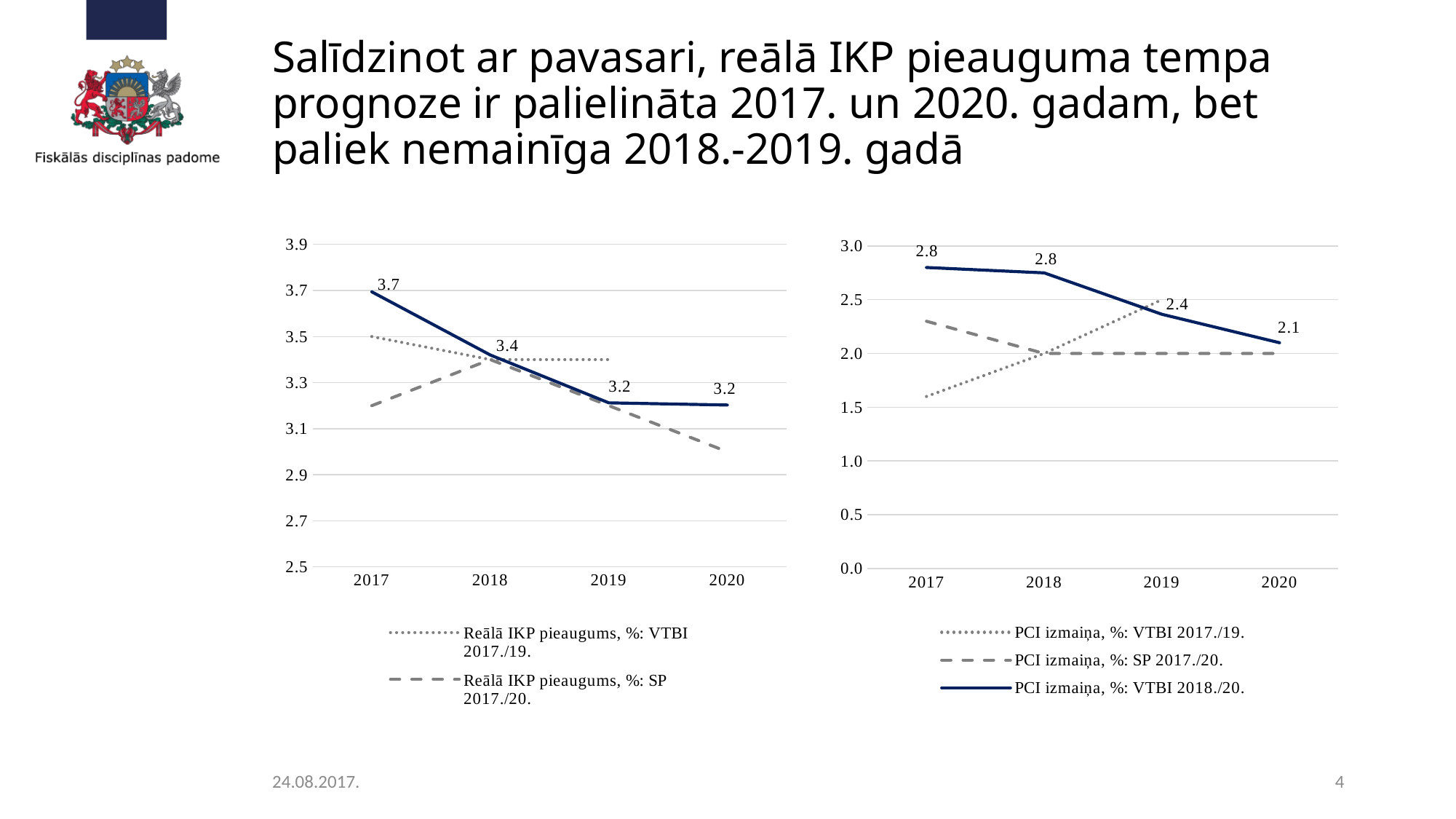
In the left chart, what is the data label shown for 2018 on the solid line? 3.4 In the right chart, how many series does the legend list? 3 In the right chart, what is the value labelled for 2019 on the solid 'PCI izmaiņa, %: VTBI 2018./20.' line? 2.4 In the right chart, what is the difference between the solid line's labelled values for 2017 and 2020? 0.7 In the right chart, what is the value labelled for 2020 on the solid 'PCI izmaiņa, %: VTBI 2018./20.' line? 2.1 In the left chart, what is the difference between the solid line's labelled values for 2017 and 2019? 0.5 In the left chart, what is the data label shown for 2017 on the solid line? 3.7 In the left chart, is the 2020 value of the dashed 'Reālā IKP pieaugums, %: SP 2017./20.' line greater or less than 3.1? less In the left chart, does the solid line rise or fall from 2017 to 2019? fall In the left chart, what is the data label shown for 2020 on the solid line? 3.2 What type of chart is shown on the right side of the slide? line chart In the right chart, is the 2017 value of the dotted 'PCI izmaiņa, %: VTBI 2017./19.' line greater or less than 2.0? less